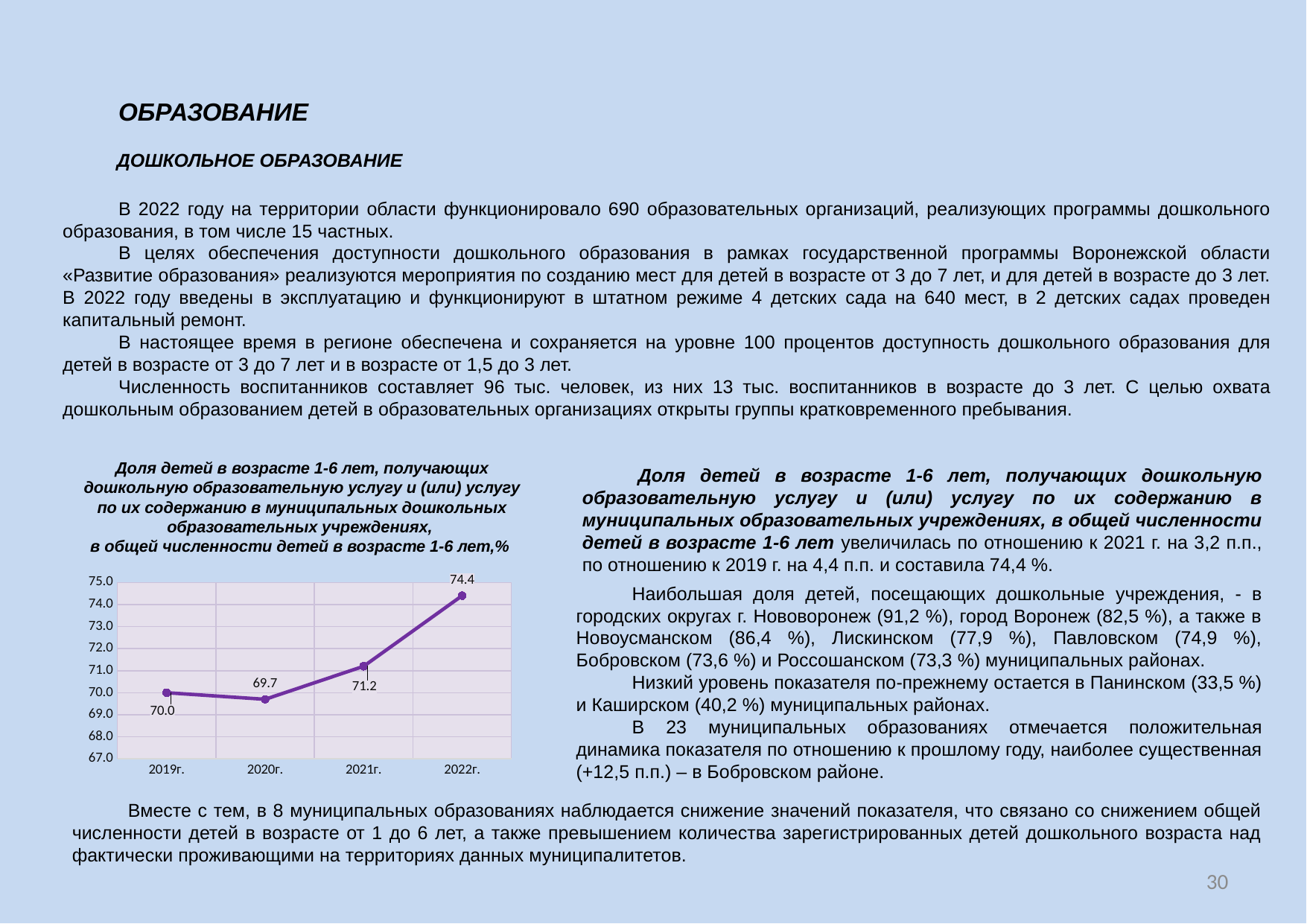
Which year has the highest value on the chart? 2022г. Does the value rise or fall from 2020г. to 2022г.? rise What kind of chart is shown on the slide? line chart What is the value for 2022г. on the chart? 74.4 Which is larger, the value for 2021г. or the value for 2020г.? 2021г. How many years are plotted on the chart? 4 Which year has the lowest value on the chart? 2020г. What is the difference between the values for 2022г. and 2019г.? 4.4 What is the value for 2021г. on the chart? 71.2 What is the value for 2019г. on the chart? 70.0 What is the value for 2020г. on the chart? 69.7 What is the difference between the values for 2022г. and 2021г.? 3.2